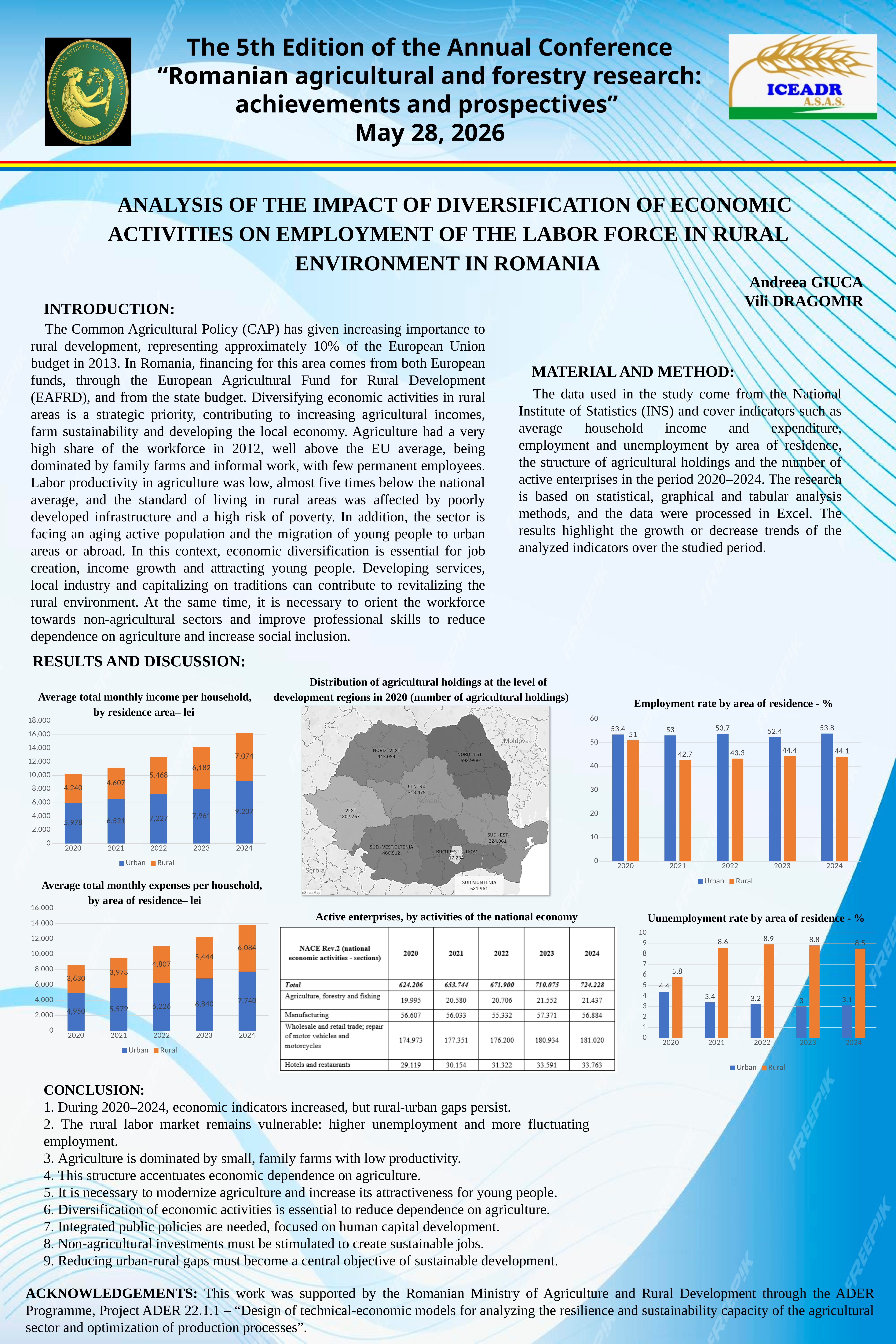
In the 'Uunemployment rate by area of residence - %' chart, which is larger in 2020, the Urban value or the Rural value? Rural In the 'Employment rate by area of residence - %' chart, what is the difference between the Urban and Rural values in 2024? 9.7 In the 'Average total monthly income per household, by residence area' chart, what is the Urban value for 2024? 9,207 In the 'Average total monthly income per household, by residence area' chart, what is the total of the stacked bar for 2020? 10,218 In the 'Employment rate by area of residence - %' chart, which year has the highest Urban value? 2024 In the 'Average total monthly expenses per household, by area of residence' chart, what is the Rural value for 2023? 5,444 In the 'Average total monthly expenses per household, by area of residence' chart, do the Urban values rise or fall from 2020 to 2024? rise In the 'Average total monthly income per household, by residence area' chart, what is the difference between the Urban and Rural values in 2022? 1,759 In the 'Employment rate by area of residence - %' chart, what is the Rural value for 2021? 42.7 In the 'Average total monthly expenses per household, by area of residence' chart, which year has the lowest Urban value? 2020 How many series does the legend of the 'Uunemployment rate by area of residence - %' chart list? 2 In the 'Uunemployment rate by area of residence - %' chart, which year has the highest Rural value? 2022